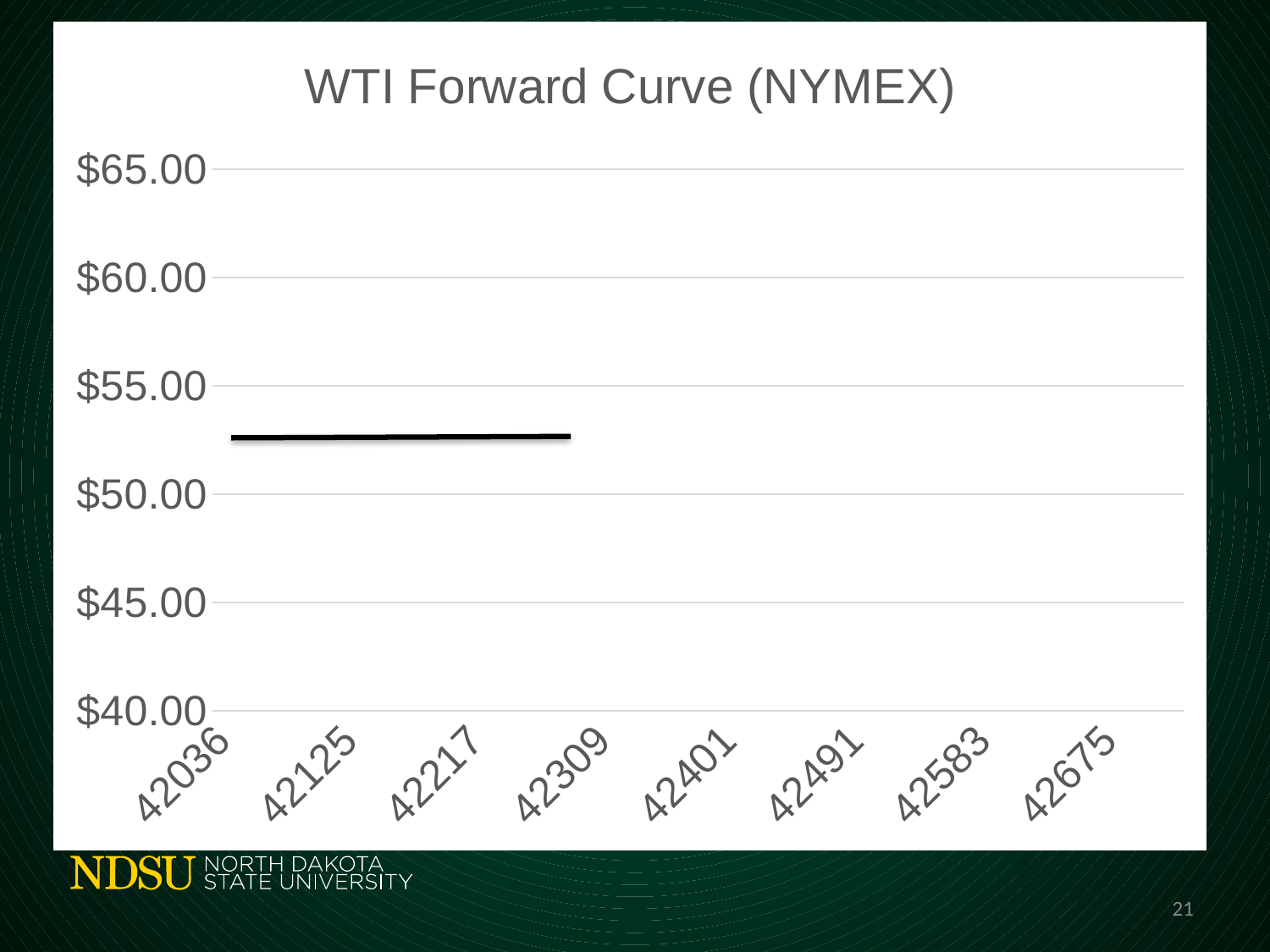
Is the value for 42217 greater or less than $55.00? less What is the title of the chart? WTI Forward Curve (NYMEX) Is the value for 42125 greater or less than $50.00? greater How many category labels are shown on the x axis? 8 What is the last category label on the x axis? 42675 Is the value for 42309 greater or less than $60.00? less What kind of chart is shown on the slide? Line chart What is the first category label on the x axis? 42036 What is the highest value shown on the y axis? $65.00 What is the lowest value shown on the y axis? $40.00